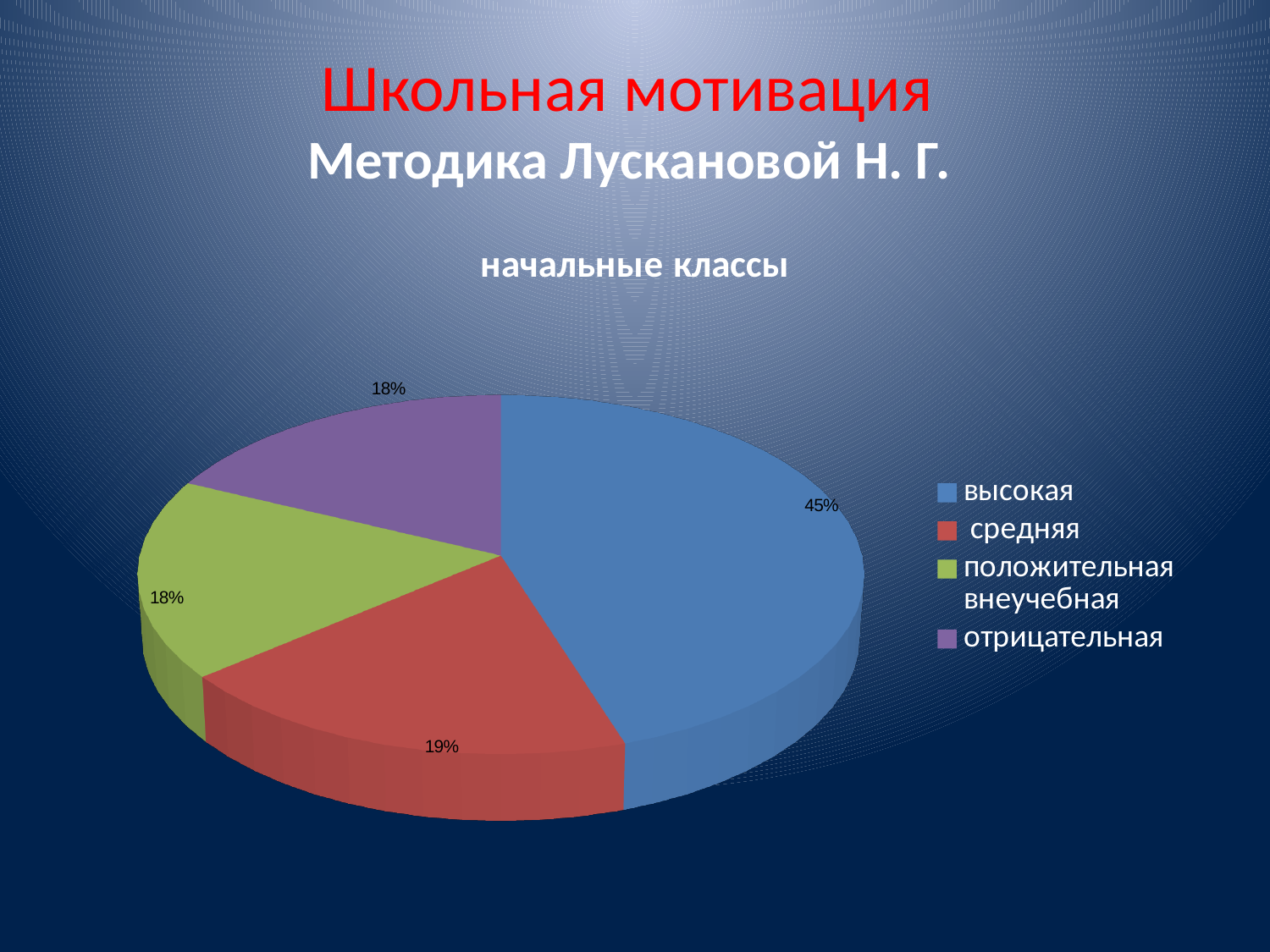
What percentage of the pie is the 'отрицательная' slice? 18% What percentage of the pie is the 'положительная внеучебная' slice? 18% What percentage of the pie is the 'средняя' slice? 19% What is the title of the chart? начальные классы Which is larger, the 'высокая' slice or the 'средняя' slice? высокая What percentage of the pie is the 'высокая' slice? 45% How many slices does the pie chart have? 4 What kind of chart is shown on the slide? pie chart How many entries does the legend list? 4 What colour is the 'отрицательная' slice? purple Which category has the largest share of the pie? высокая What is the difference in percentage points between the 'высокая' and 'средняя' slices? 26